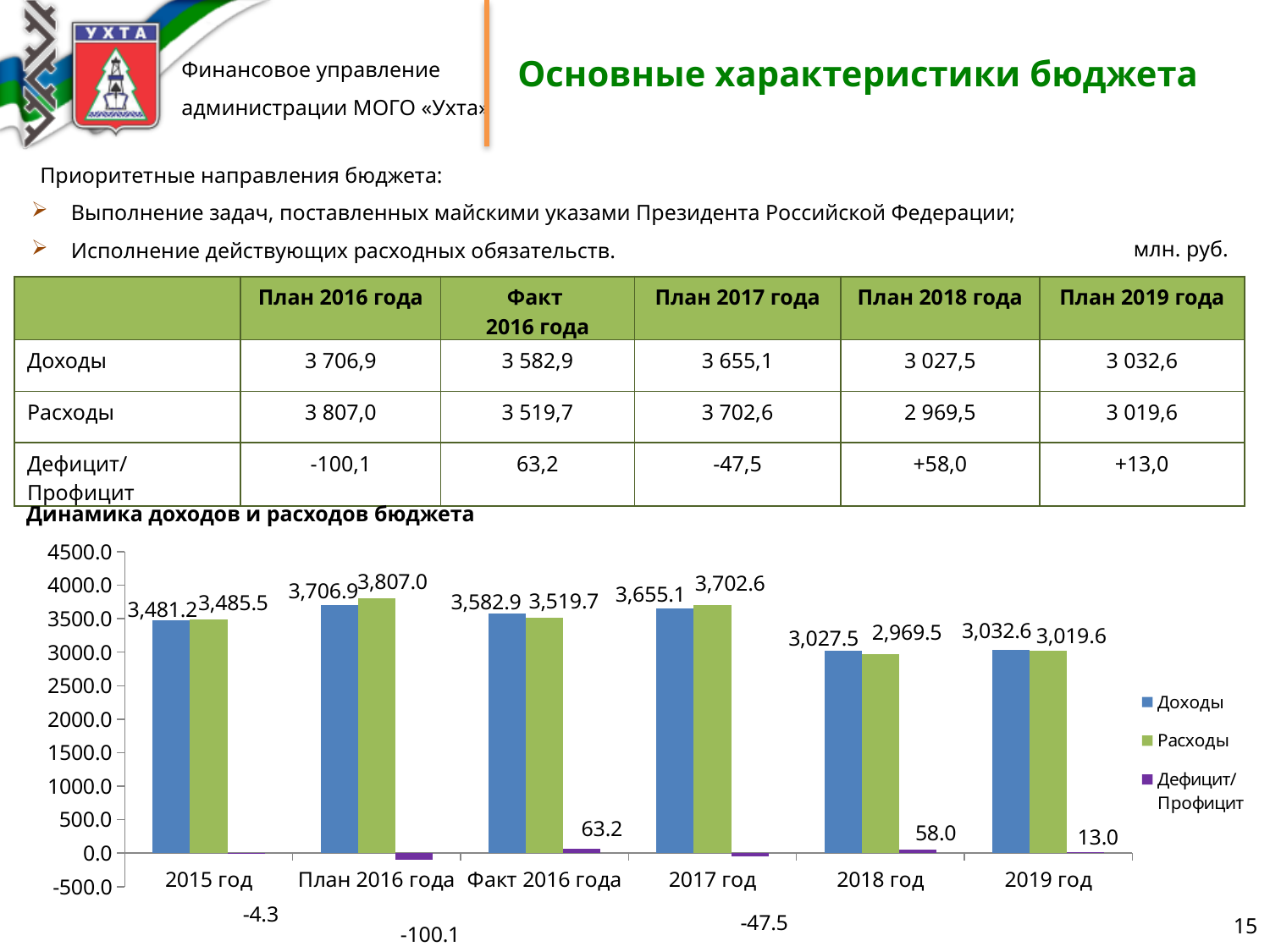
What is the value of Доходы for Факт 2016 года in the chart? 3,582.9 How many series does the legend of the chart list? 3 Is the value of Доходы for 2019 год greater or less than 3500.0? less In which category is Доходы lowest in the chart? 2018 год What is the difference between Расходы and Доходы for План 2016 года in the chart? 100.1 What is the value of Дефицит/Профицит for 2017 год in the chart? -47.5 Which series in the chart is shown in green? Расходы What is the value of Расходы for 2018 год in the chart? 2,969.5 For 2017 год, which is larger in the chart: Доходы or Расходы? Расходы How many categories are shown along the x axis of the chart? 6 In which category is Расходы highest in the chart? План 2016 года What type of chart is shown under the heading "Динамика доходов и расходов бюджета"? bar chart